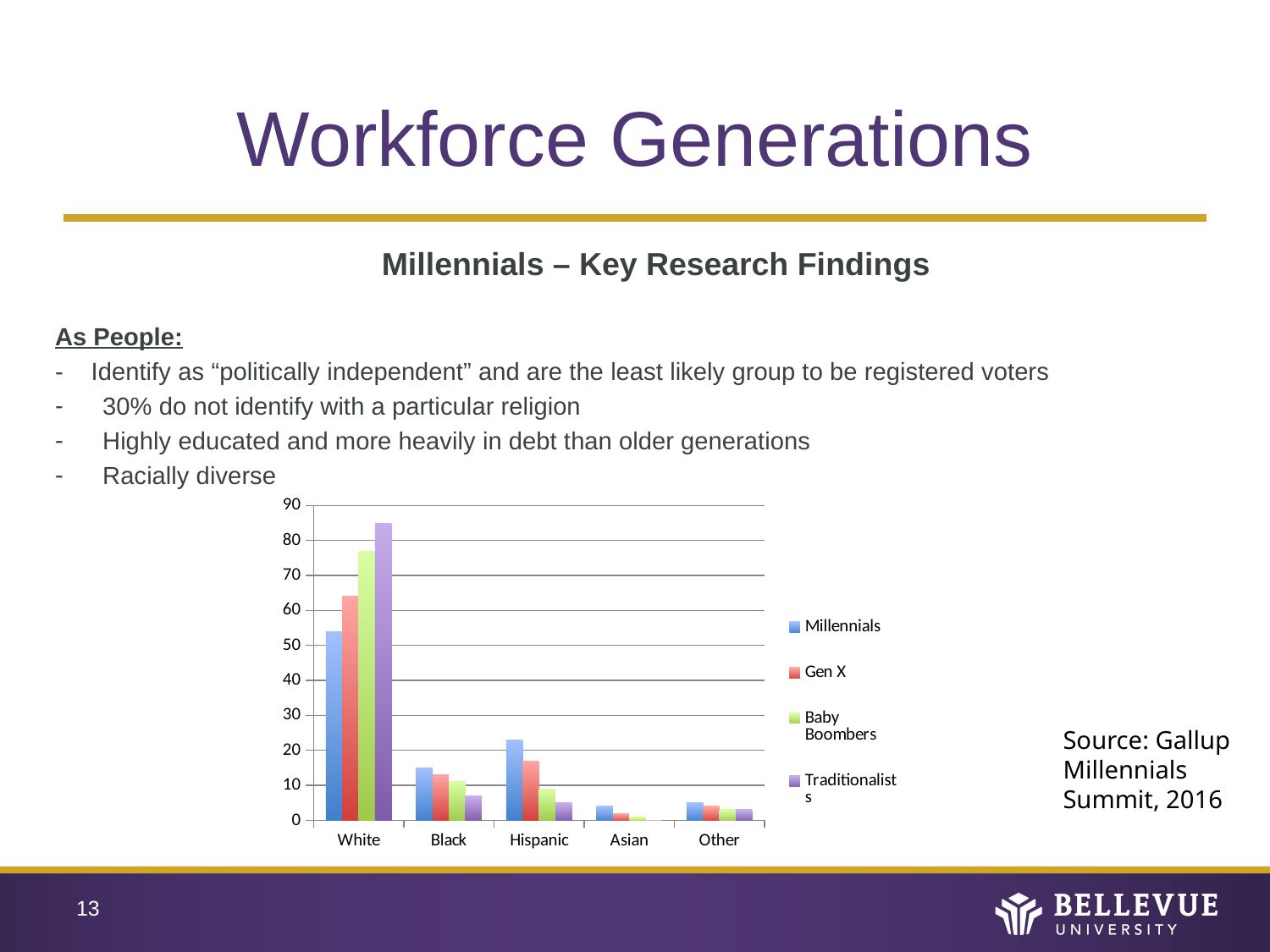
How many series does the chart's legend list? 4 Is the Baby Boomers value for White greater or less than 70? greater What are the four series listed in the chart's legend? Millennials, Gen X, Baby Boombers, Traditionalists Which series has the highest value for the White category? Traditionalists Is the Millennials value for Hispanic greater or less than 20? greater Which category has the highest value for the Traditionalists series? White How many categories are shown on the x axis of the chart? 5 Is the Millennials value for White greater or less than 60? less What kind of chart is shown on the slide? bar chart For the Hispanic category, which is larger: the Millennials value or the Traditionalists value? Millennials Which series has the lowest value for the Hispanic category? Traditionalists